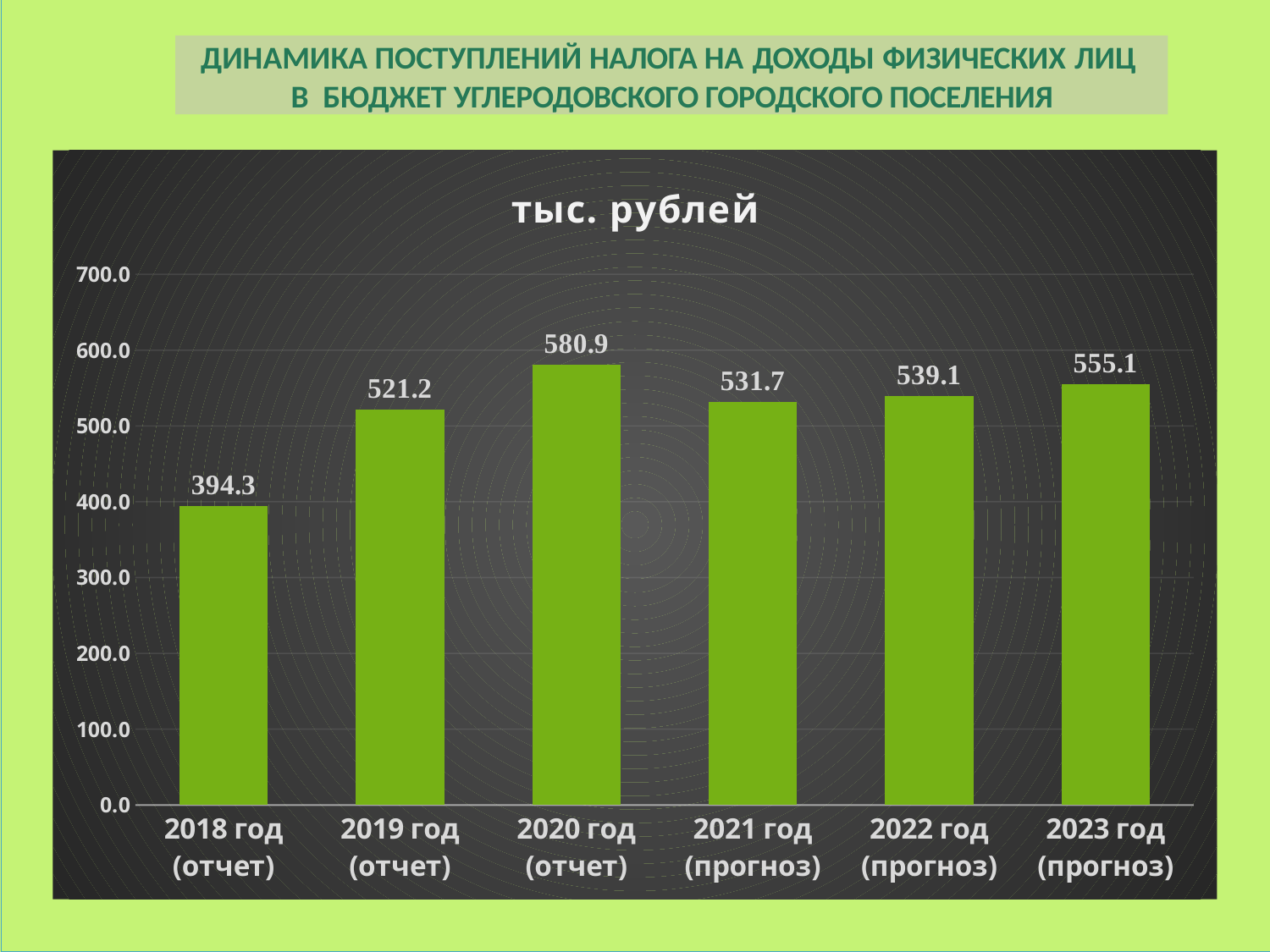
What is the title shown inside the chart area? тыс. рублей Which year has the highest value? 2020 год (отчет) What is the value for 2023 год (прогноз)? 555.1 Which year has the lowest value? 2018 год (отчет) What kind of chart is shown on the slide? bar chart Is the value for 2018 год (отчет) greater or less than 400.0? less Which is larger, the value for 2019 год (отчет) or 2021 год (прогноз)? 2021 год (прогноз) What is the value for 2020 год (отчет)? 580.9 What is the difference between the values for 2023 год (прогноз) and 2022 год (прогноз)? 16.0 What is the difference between the values for 2020 год (отчет) and 2018 год (отчет)? 186.6 How many bars are shown in the chart? 6 What is the value for 2018 год (отчет)? 394.3